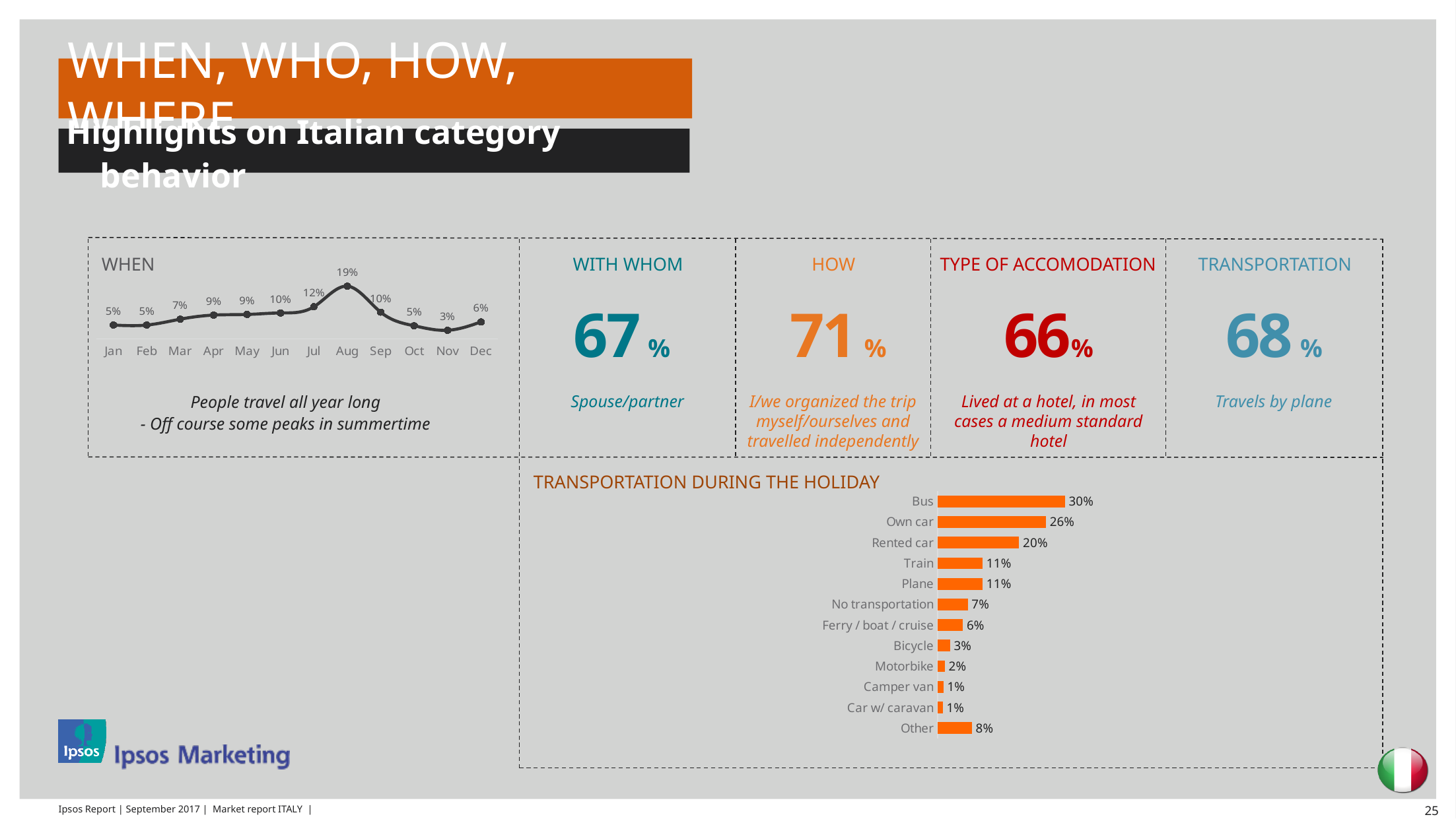
In the TRANSPORTATION DURING THE HOLIDAY chart, which category has the highest value? Bus In the TRANSPORTATION DURING THE HOLIDAY chart, what kind of chart is shown? Bar chart In the WHEN line chart, what kind of chart is shown? Line chart In the TRANSPORTATION DURING THE HOLIDAY chart, what is the difference between Bus and Own car? 4% In the WHEN line chart, how many months are plotted? 12 In the WHEN line chart, what is the value for Aug? 19% In the WHEN line chart, which month has the highest value? Aug In the TRANSPORTATION DURING THE HOLIDAY chart, how many categories are shown? 12 In the TRANSPORTATION DURING THE HOLIDAY chart, what is the value for Rented car? 20% In the WHEN line chart, which month has the lowest value? Nov In the WHEN line chart, what is the difference between the values for Aug and Jul? 7% In the TRANSPORTATION DURING THE HOLIDAY chart, which is larger, Ferry / boat / cruise or No transportation? No transportation